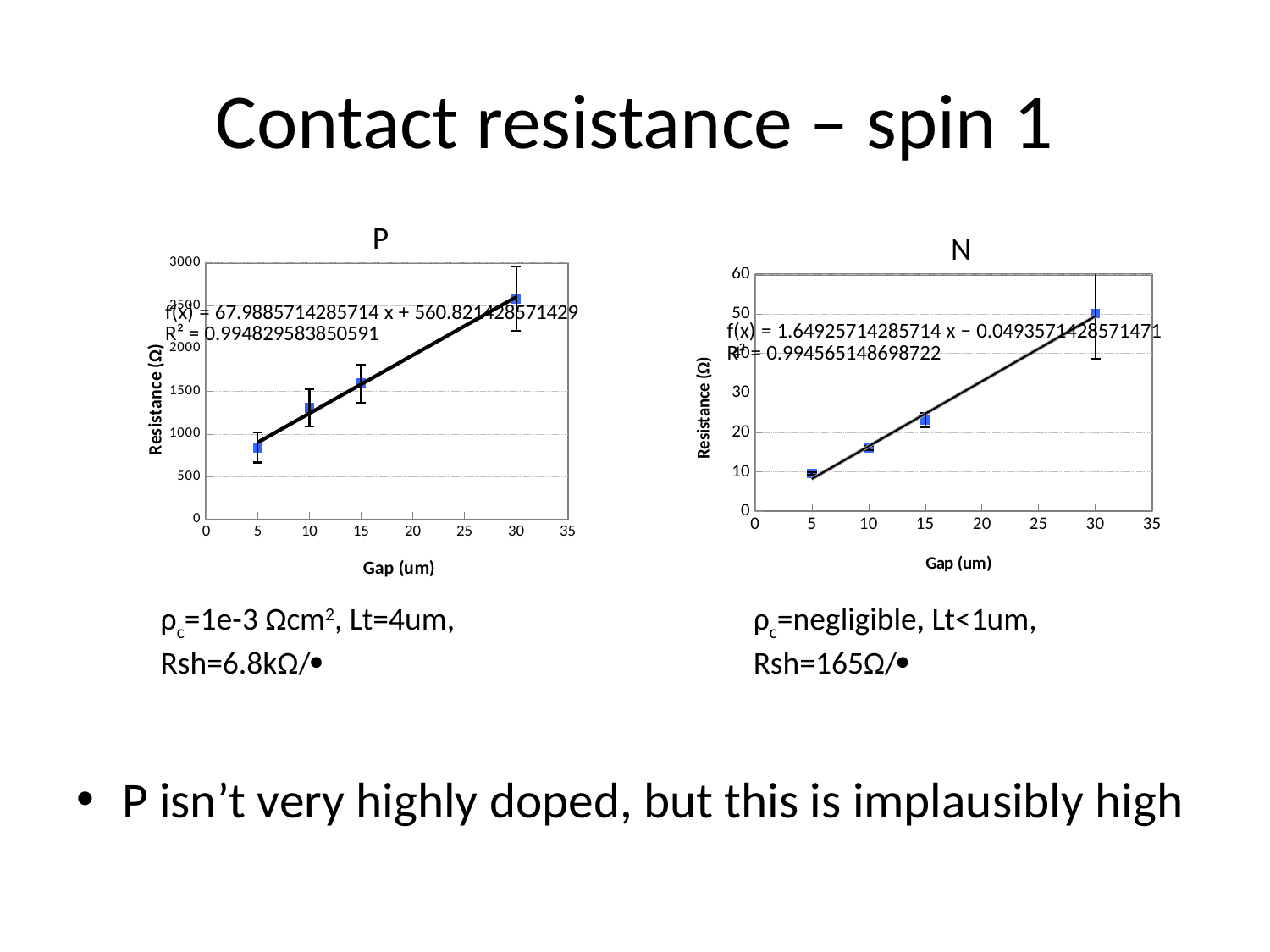
In the chart titled P, is the resistance at a gap of 30 um greater or less than 2000? greater In the chart titled N, is the resistance at a gap of 5 um greater or less than 20? less In the chart titled P, how many data points are plotted? 4 In the chart titled N, do the resistance values rise or fall as the gap increases? rise What is the x-axis title of the chart titled P? Gap (um) What R² value is printed on the chart titled N? 0.994565148698722 In the chart titled P, is the resistance at a gap of 5 um greater or less than 1000? less In the chart titled P, do the resistance values rise or fall as the gap increases? rise In the chart titled N, how many data points are plotted? 4 What kind of chart is the chart titled P? scatter chart